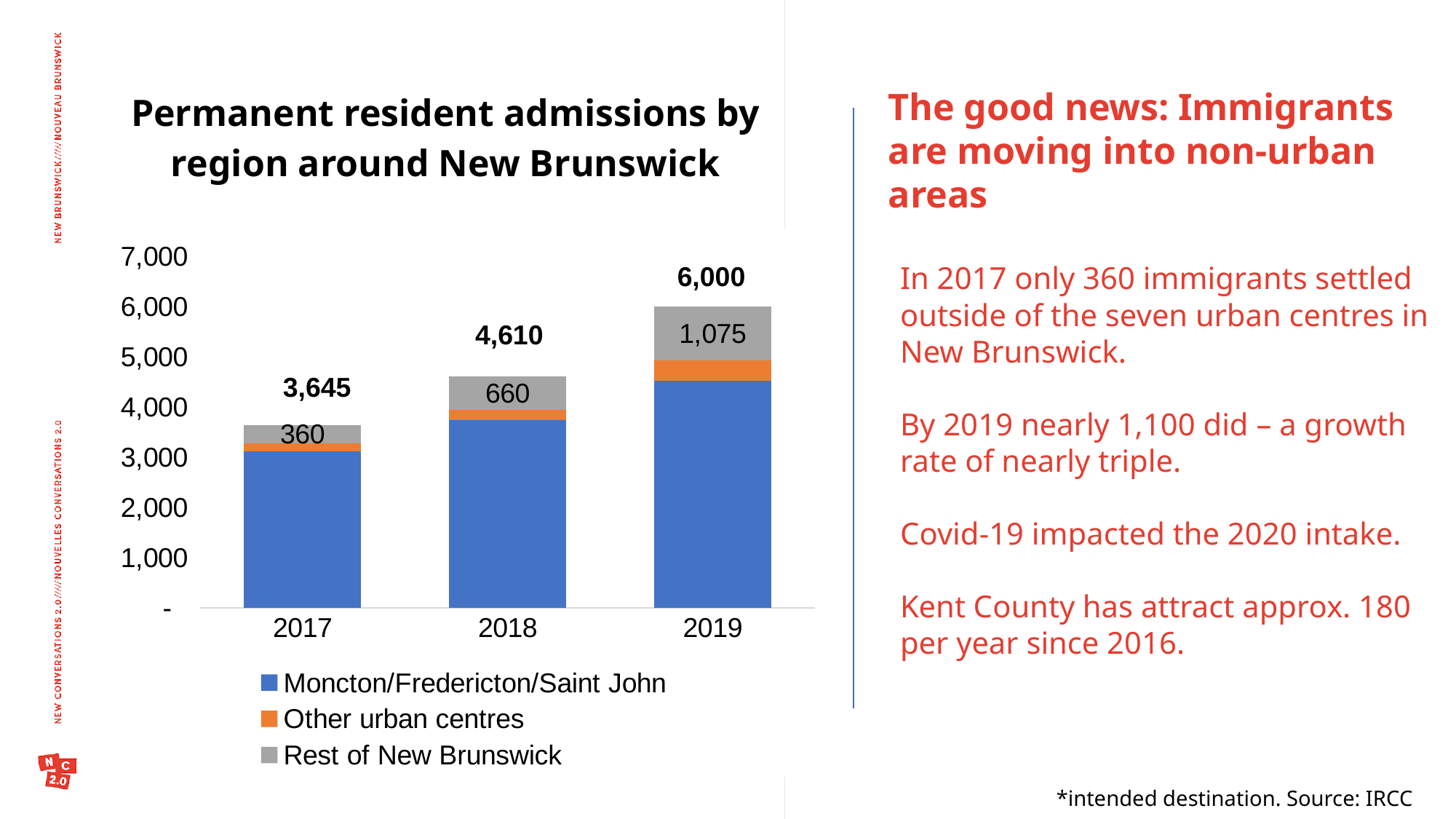
What value is labelled for Rest of New Brunswick in 2018? 660 Which year has the lowest value for Rest of New Brunswick? 2017 Which year has the highest total permanent resident admissions? 2019 How many years are shown on the x axis of the chart? 3 How many series does the chart's legend list? 3 Do the total permanent resident admissions rise or fall from 2017 to 2019? rise What is the total permanent resident admissions shown for 2017? 3,645 Is the value for Moncton/Fredericton/Saint John in 2019 greater or less than 4,000? greater What value is labelled for Rest of New Brunswick in 2019? 1,075 By how much did the Rest of New Brunswick value increase from 2017 to 2019? 715 What is the difference between the total admissions in 2019 and 2017? 2,355 What is the total permanent resident admissions shown for 2019? 6,000